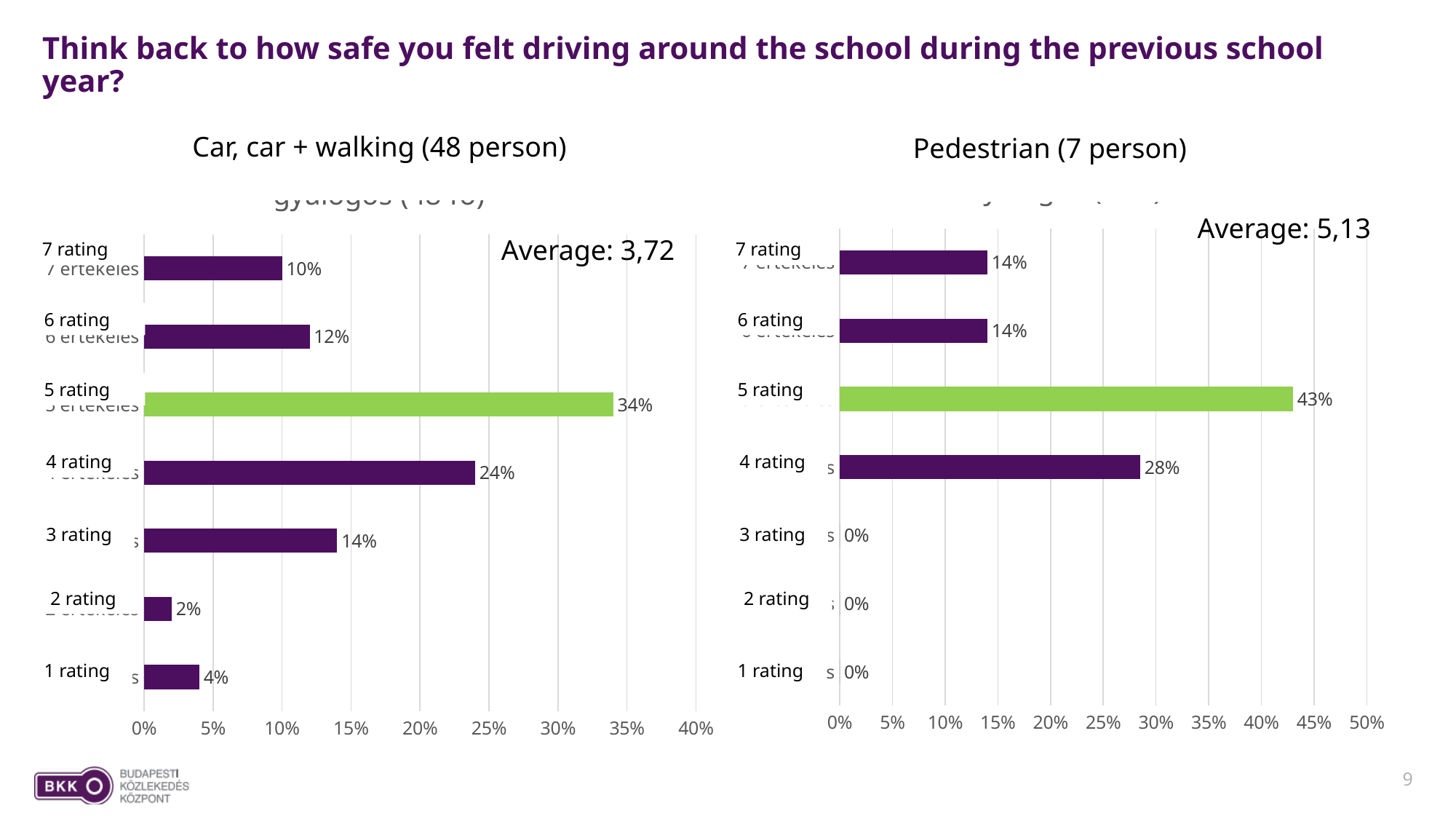
What type of chart is the 'Car, car + walking (48 person)' chart? Bar chart In the 'Car, car + walking (48 person)' chart, what is the difference between the 5 rating and the 4 rating values? 10% In the 'Car, car + walking (48 person)' chart, what is the value for the 5 rating? 34% In the 'Pedestrian (7 person)' chart, which rating has the highest value? 5 rating In the 'Pedestrian (7 person)' chart, what is the value for the 4 rating? 28% In the 'Pedestrian (7 person)' chart, how many ratings have a value of 0%? 3 What average is shown for the 'Pedestrian (7 person)' chart? 5,13 In the 'Car, car + walking (48 person)' chart, which rating has the lowest value? 2 rating How many rating categories are shown in the 'Pedestrian (7 person)' chart? 7 In the 'Car, car + walking (48 person)' chart, which is larger: the value for the 6 rating or the 3 rating? 3 rating In the 'Pedestrian (7 person)' chart, what is the difference between the 5 rating and the 7 rating values? 29% In the 'Car, car + walking (48 person)' chart, what is the value for the 1 rating? 4%